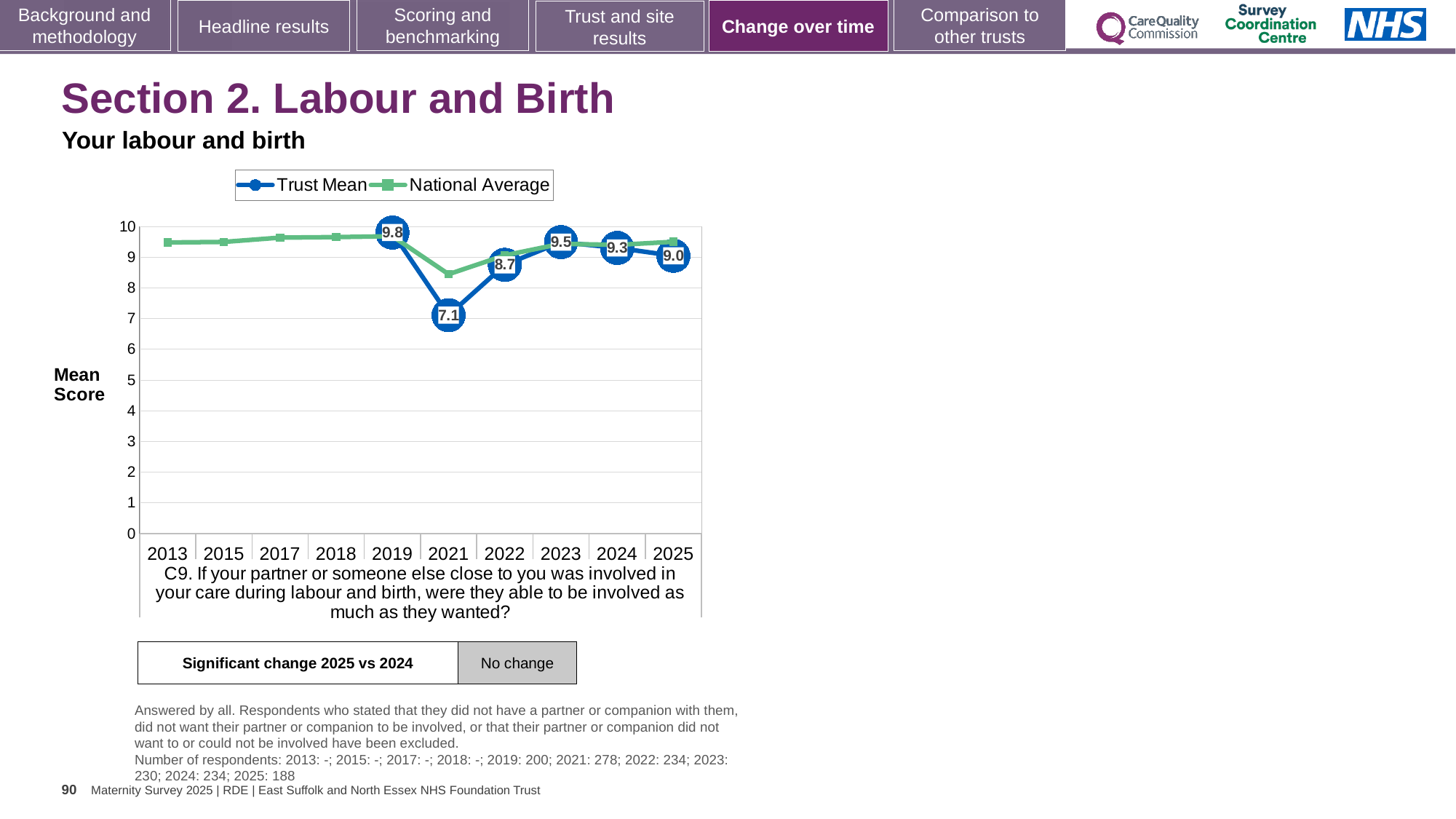
In which year is the Trust Mean lowest? 2021 What is the Trust Mean score for 2019? 9.8 How many series does the legend list? 2 In which year is the Trust Mean highest? 2019 What is the difference between the Trust Mean in 2019 and in 2021? 2.7 What is the Trust Mean score for 2025? 9.0 How many years are shown on the x axis? 10 Does the Trust Mean rise or fall from 2023 to 2025? fall What is the Trust Mean score for 2021? 7.1 What kind of chart is shown? line chart Which is larger, the Trust Mean in 2023 or in 2025? 2023 Is the National Average value for 2021 greater or less than 9? less